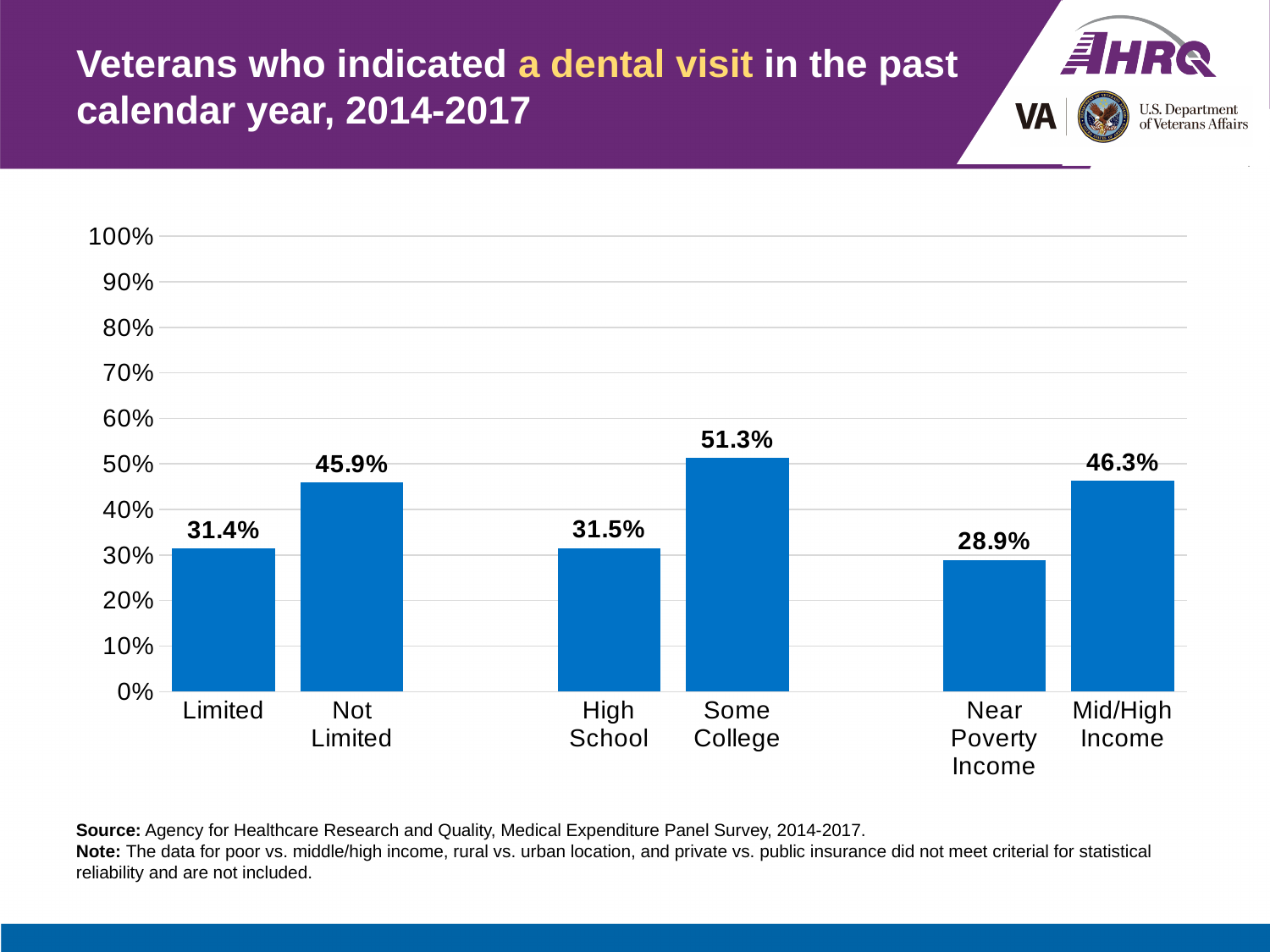
What is the difference between the Some College and High School values? 19.8% What is the difference between the Not Limited and Limited values? 14.5% What percentage of veterans with limited activity indicated a dental visit in the past calendar year? 31.4% How many categories are shown on the chart? 6 Which category has the lowest value on the chart? Near Poverty Income Is the value for Some College greater or less than 50%? greater What is the value shown for the Near Poverty Income category? 28.9% What is the value shown for the Mid/High Income category? 46.3% Which category has the highest value on the chart? Some College Which is larger, the value for Mid/High Income or the value for Not Limited? Mid/High Income What is the value shown for the Some College category? 51.3% What kind of chart is shown on the slide? Bar chart